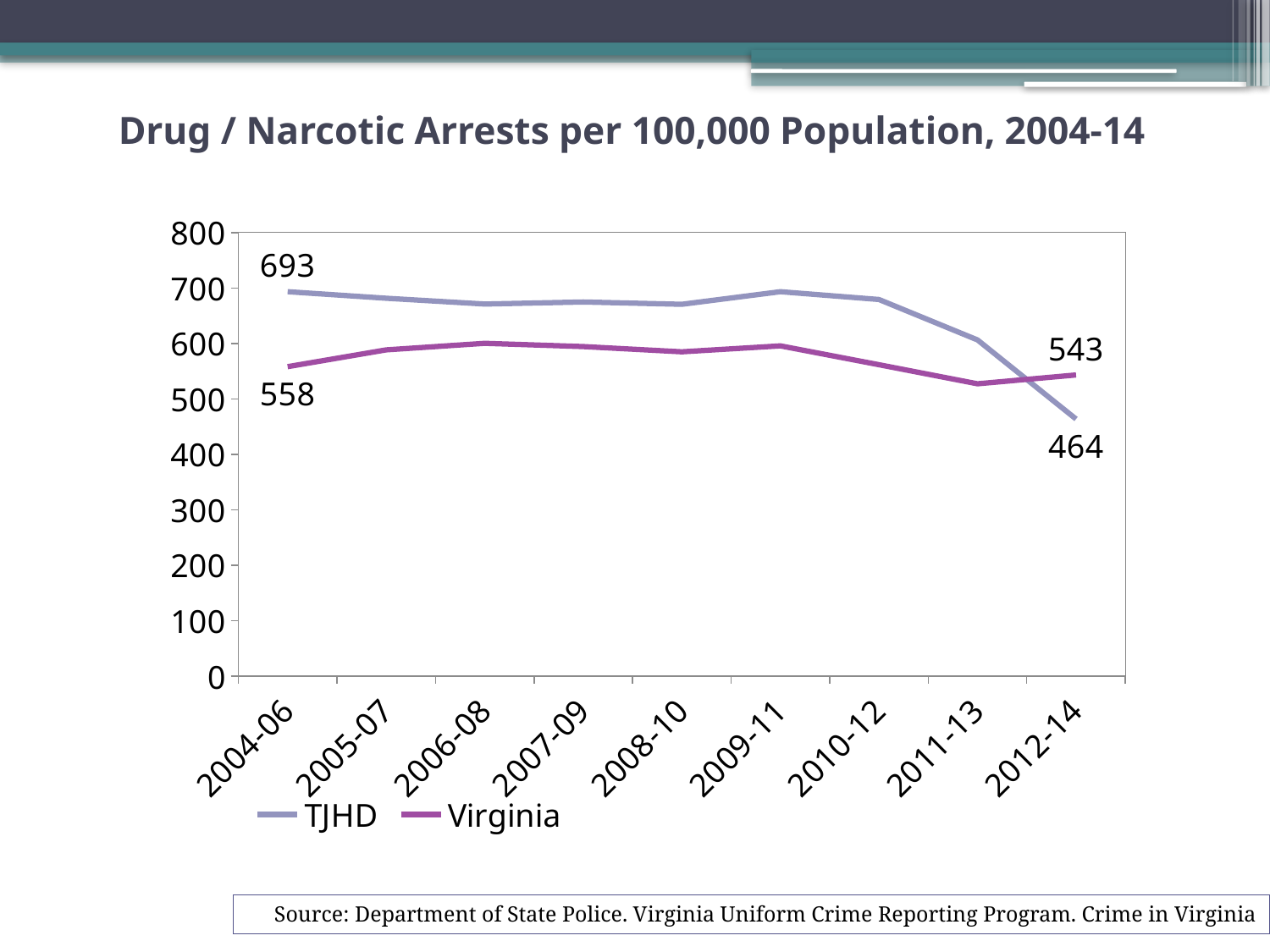
How many periods are shown on the x axis? 9 Which series has the higher value in 2012-14, TJHD or Virginia? Virginia Is the TJHD value for 2011-13 greater or less than 500? greater Which series has the higher value in 2004-06, TJHD or Virginia? TJHD How many series does the legend list? 2 What is the difference between the TJHD and Virginia values in 2004-06? 135 What kind of chart is shown on the slide? Line chart By how much did the TJHD value fall from 2004-06 to 2012-14? 229 What is the Virginia value for 2012-14? 543 What is the Virginia value for 2004-06? 558 What is the TJHD value for 2004-06? 693 What is the TJHD value for 2012-14? 464